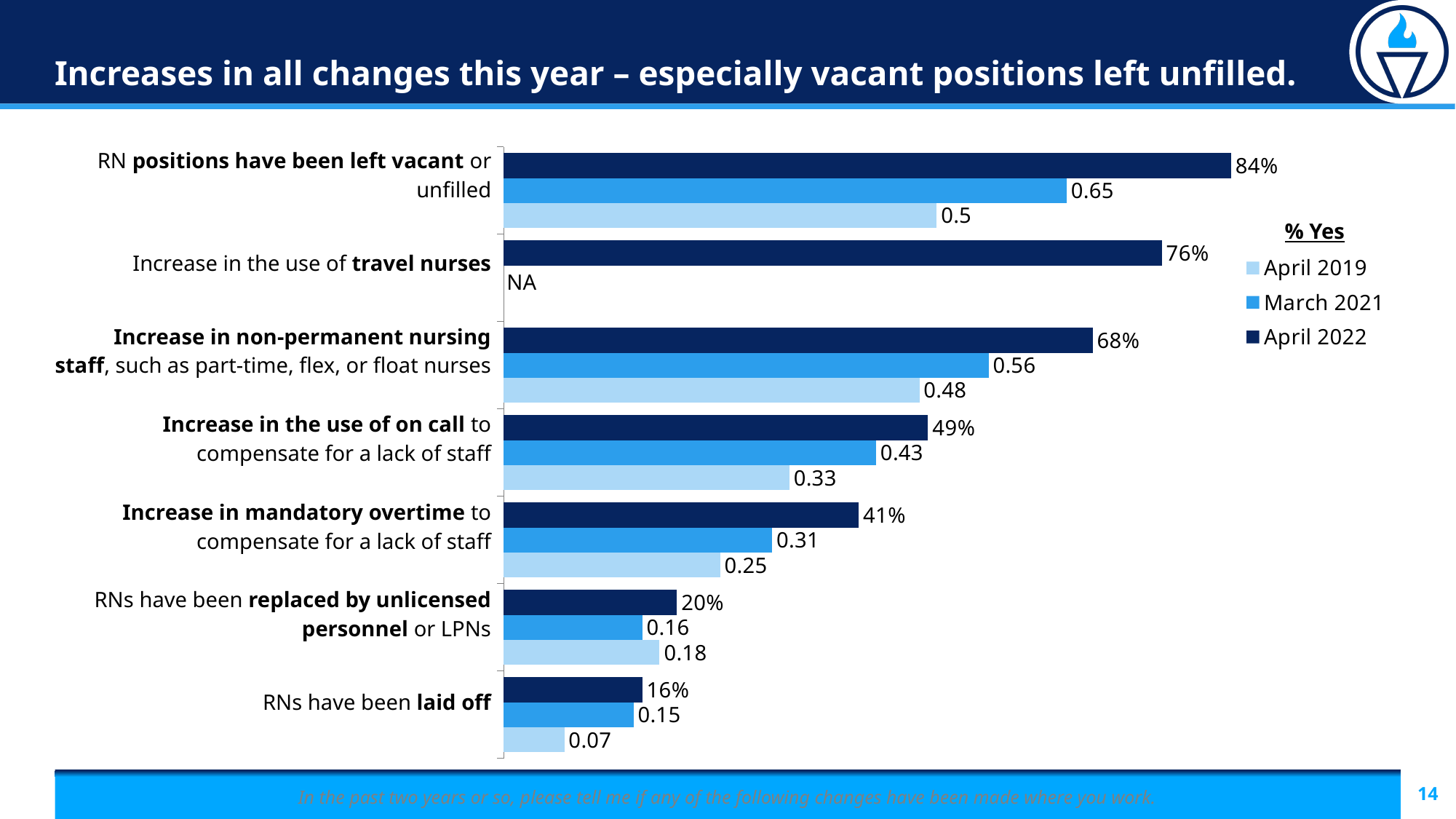
Which category has the highest April 2022 value? RN positions have been left vacant or unfilled For "RNs have been replaced by unlicensed personnel or LPNs", which is larger: the April 2019 value or the March 2021 value? April 2019 How many series does the legend list? 3 What is the difference between the March 2021 and April 2019 values for "Increase in mandatory overtime to compensate for a lack of staff"? 0.06 What is the March 2021 value for "Increase in the use of on call to compensate for a lack of staff"? 0.43 How many categories are shown on the chart? 7 Which category has the lowest April 2019 value? RNs have been laid off What is the April 2019 value for "RNs have been laid off"? 0.07 What kind of chart is shown on the slide? Bar chart What is the heading above the legend? % Yes What is the April 2022 value for "RN positions have been left vacant or unfilled"? 84%